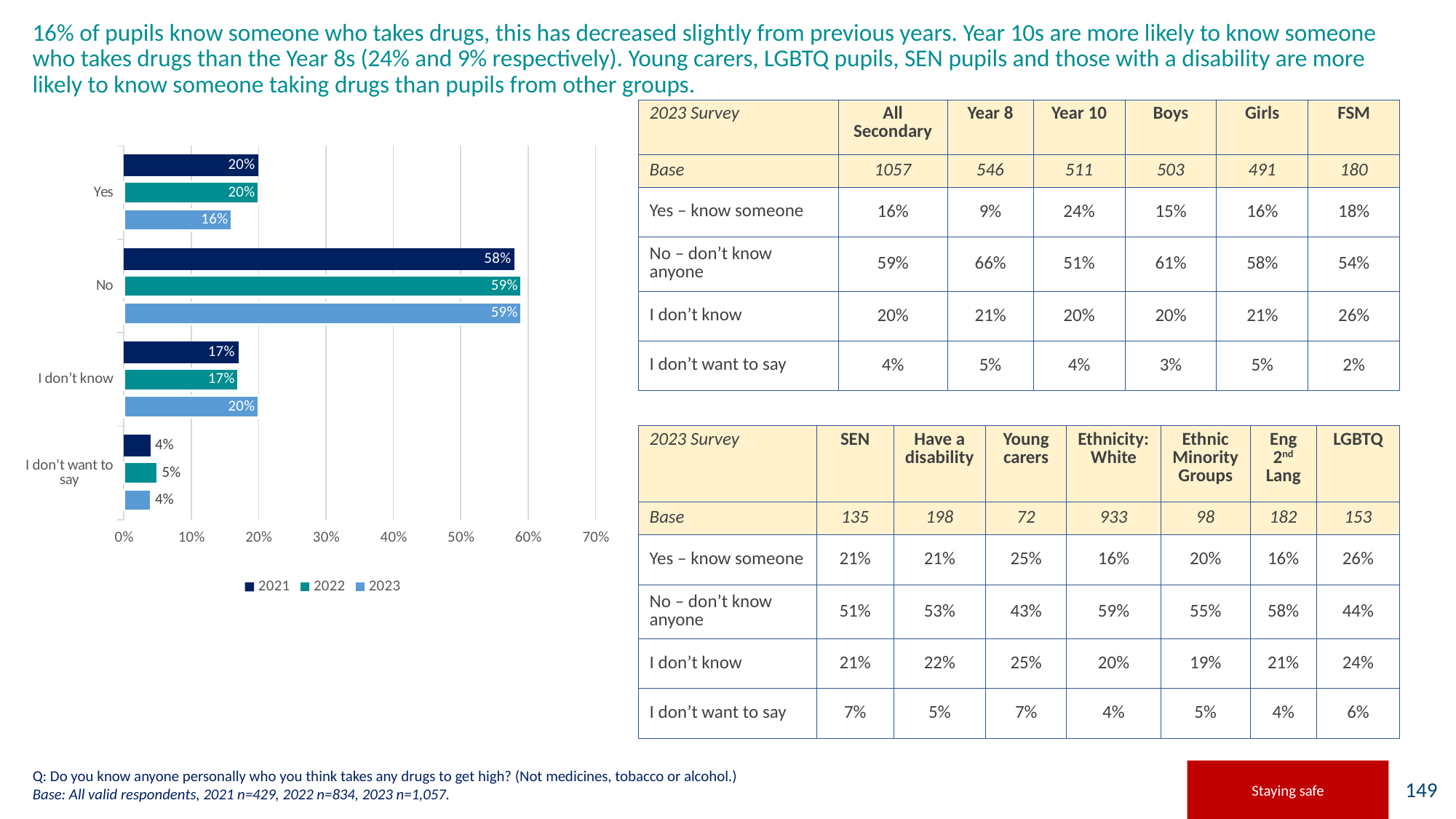
What is the difference between the 2021 and 2023 values for 'Yes' in the bar chart? 4% What is the 2023 value for 'I don't know' in the bar chart? 20% What is the 2023 value for 'Yes' in the bar chart? 16% Which category has the lowest value for 2021 in the bar chart? I don't want to say What type of chart is shown on the slide? bar chart How many response categories are shown in the bar chart? 4 Which years are listed in the legend of the bar chart? 2021, 2022, 2023 How many series does the legend of the bar chart list? 3 Is the 2022 value for 'I don't know' larger or smaller than the 2023 value for 'I don't know' in the bar chart? smaller What is the 2021 value for 'No' in the bar chart? 58% What is the 2022 value for 'I don't want to say' in the bar chart? 5% Which category has the highest value for 2023 in the bar chart? No